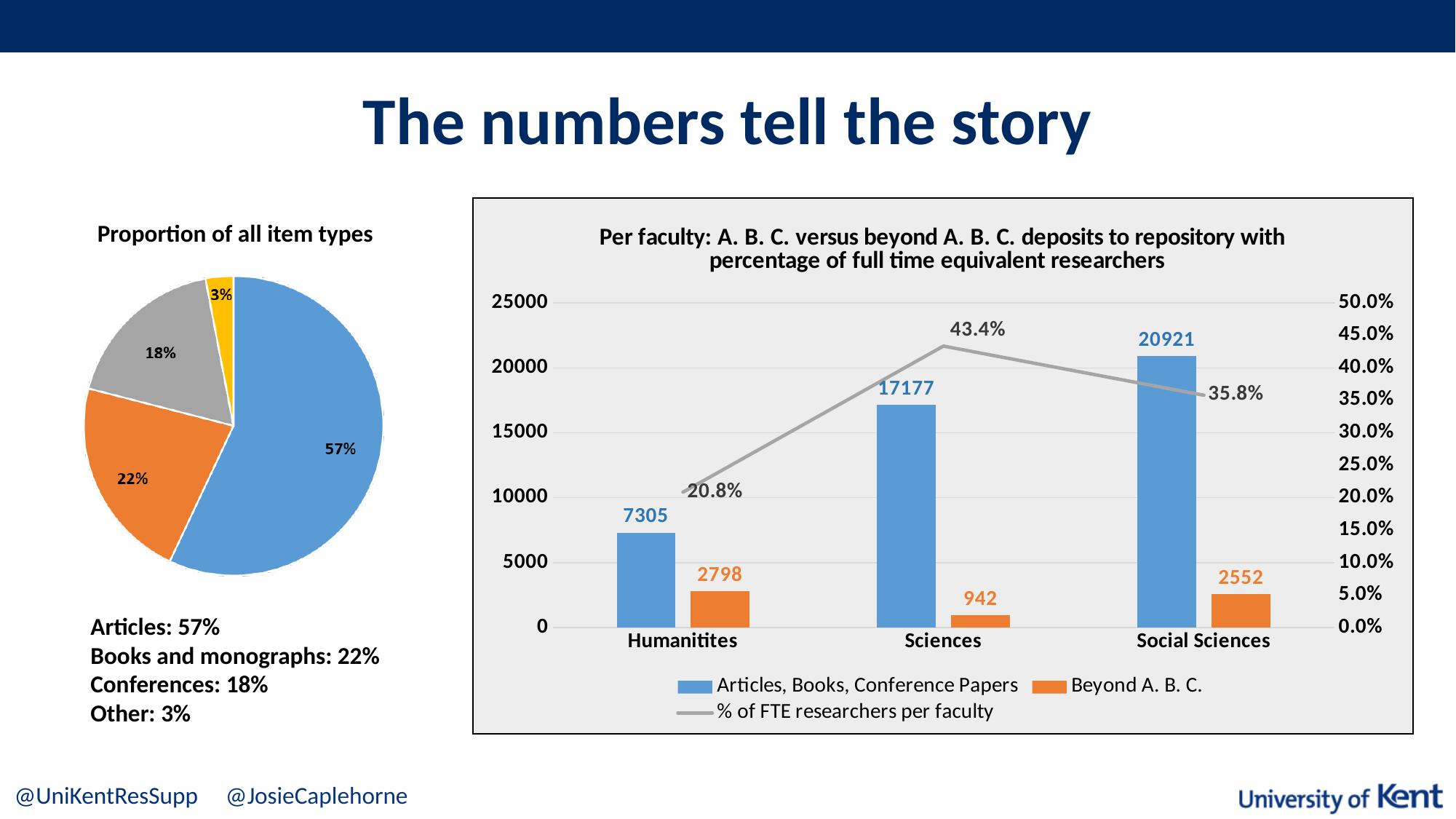
In the 'Per faculty' chart on the right, how many series does the legend list? 3 In the 'Per faculty' chart on the right, what is the % of FTE researchers per faculty for Sciences? 43.4% In the 'Per faculty' chart on the right, what is the value of Articles, Books, Conference Papers for Sciences? 17177 In the 'Per faculty' chart on the right, what is the value of Beyond A. B. C. for Humanitites? 2798 In the 'Per faculty' chart on the right, what is the difference between the Articles, Books, Conference Papers values for Social Sciences and Humanitites? 13616 In the 'Per faculty' chart on the right, is the Beyond A. B. C. value for Social Sciences larger or smaller than the Beyond A. B. C. value for Humanitites? smaller In the 'Per faculty' chart on the right, which faculty has the highest Articles, Books, Conference Papers value? Social Sciences In the 'Proportion of all item types' pie chart, how many slices are there? 4 In the 'Proportion of all item types' pie chart, what is the difference between the Books and monographs share and the Conferences share? 4% In the 'Per faculty' chart on the right, which faculty has the lowest Beyond A. B. C. value? Sciences In the 'Proportion of all item types' pie chart, what share of the pie is Articles? 57% In the 'Proportion of all item types' pie chart, which item type has the smallest slice? Other